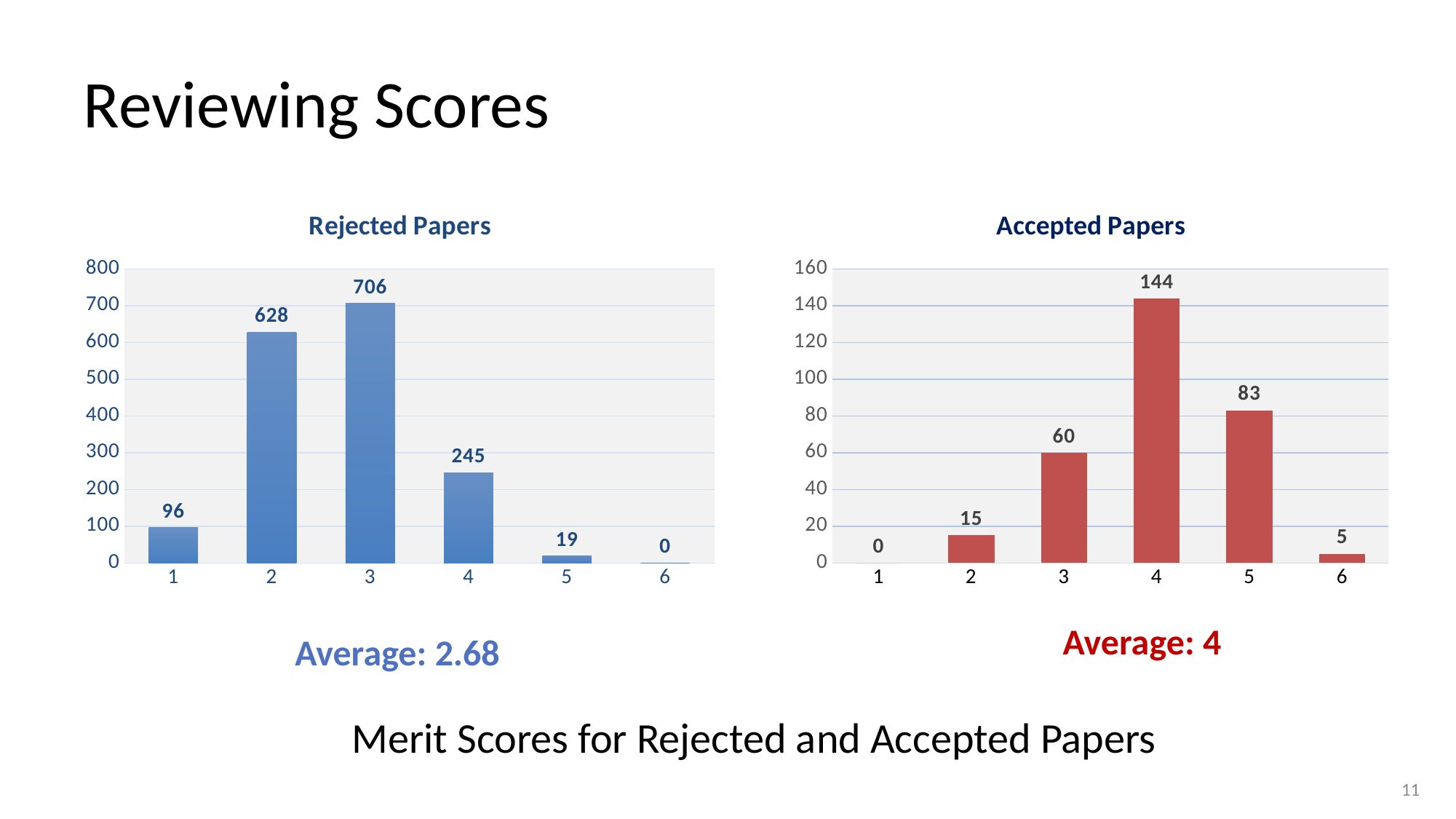
In the Accepted Papers chart, what is the value for score 5? 83 In the Rejected Papers chart, what is the difference between the values for score 2 and score 4? 383 In the Accepted Papers chart, which score has the lowest value? 1 What is the title of the chart on the right side of the slide? Accepted Papers In the Accepted Papers chart, what is the difference between the values for score 4 and score 3? 84 What kind of chart is the Rejected Papers chart? bar chart In the Rejected Papers chart, which score has the highest value? 3 In the Rejected Papers chart, what is the value for score 3? 706 In the Rejected Papers chart, is the value for score 4 greater or less than 300? less In the Accepted Papers chart, do the values rise or fall from score 4 to score 6? fall How many score categories are shown on the x axis of the Accepted Papers chart? 6 In the Accepted Papers chart, which is larger, the value for score 2 or the value for score 6? score 2